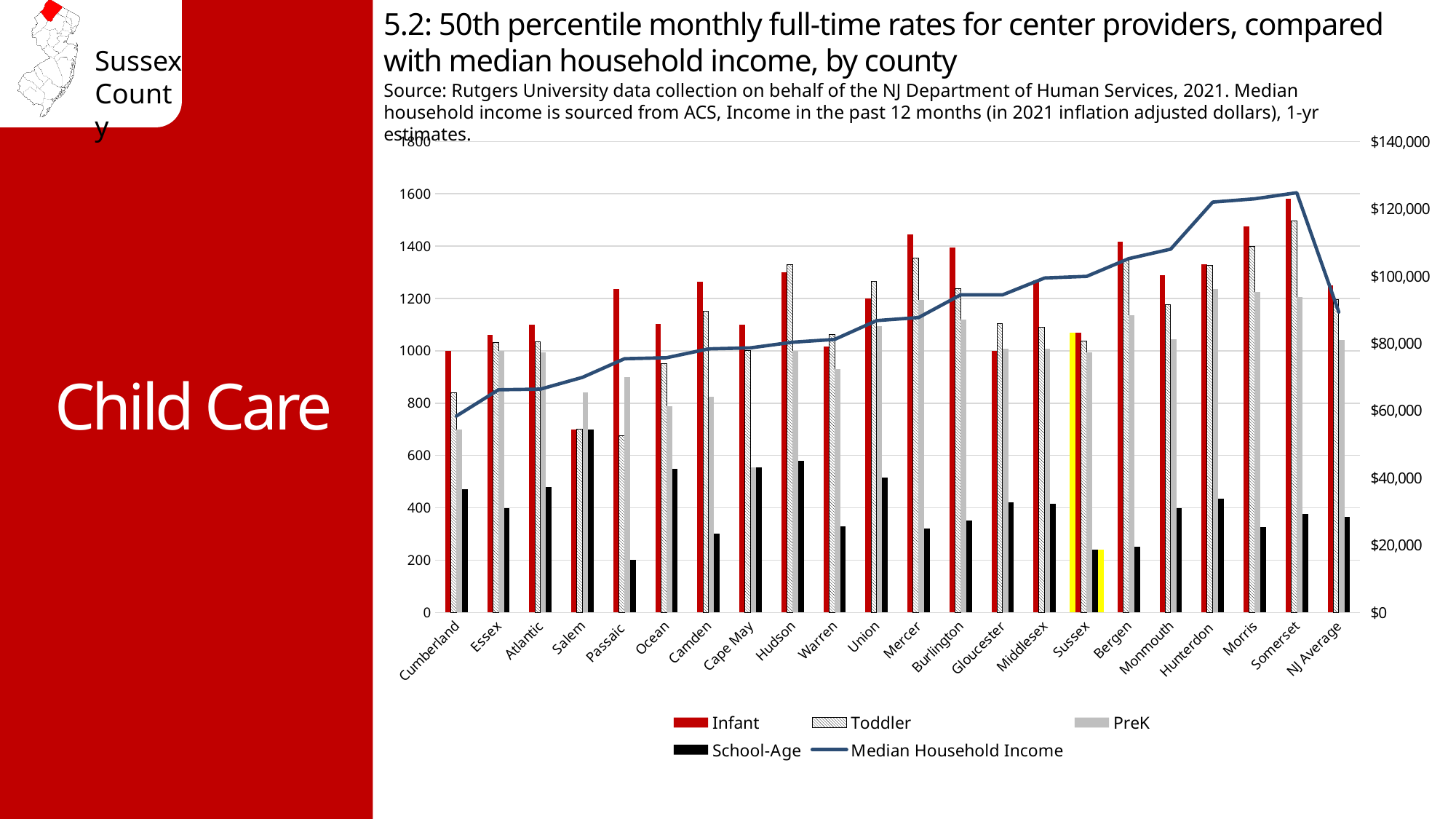
Is the School-Age rate for Sussex greater or less than 400? less Which county has the lowest School-Age rate? Passaic How many counties/categories are shown along the x axis of the chart? 22 Which county has the highest Median Household Income? Somerset How many series does the chart legend list? 5 Is the Infant rate for Somerset greater or less than 1400? greater Which county has the lowest Median Household Income? Cumberland What kind of chart is shown on the slide? Bar chart with a line Which county has the highest School-Age rate? Salem Is the Median Household Income for Cumberland greater or less than $80,000? less Which county has the highest Infant rate? Somerset Which is larger, the Infant rate for Mercer or the Infant rate for Hudson? Mercer